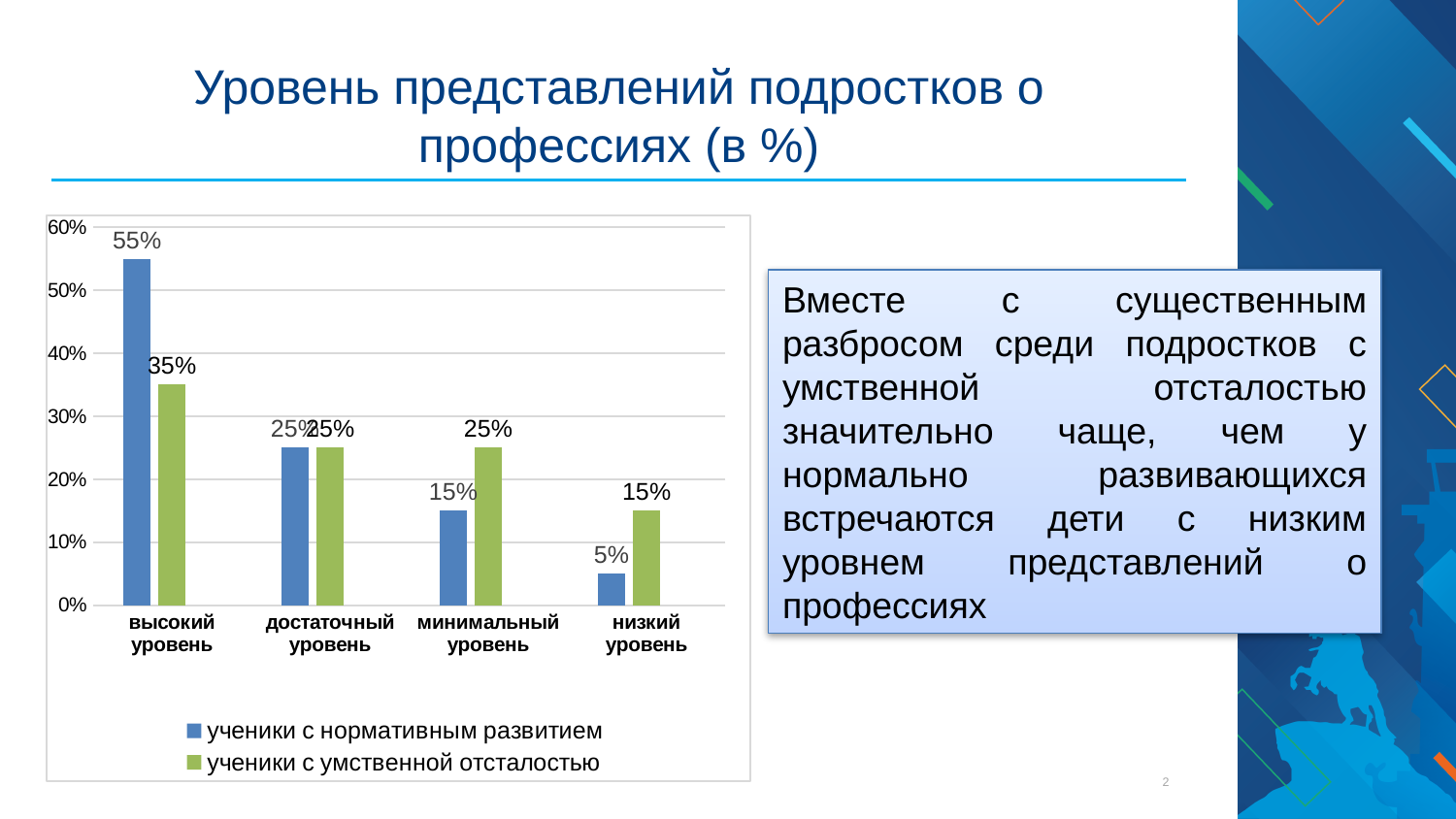
At «низкий уровень», which series has the larger value? ученики с умственной отсталостью What type of chart is shown on the slide? bar chart Which category has the highest value for «ученики с нормативным развитием»? высокий уровень How many series does the legend list? 2 What is the value for «ученики с нормативным развитием» at «высокий уровень»? 55% Which category has the lowest value for «ученики с умственной отсталостью»? низкий уровень How many categories are shown on the x axis? 4 What is the value for «ученики с умственной отсталостью» at «минимальный уровень»? 25% What is the difference between the two series at «высокий уровень»? 20% Does the value for «ученики с нормативным развитием» fall or rise from «высокий уровень» to «низкий уровень»? fall What is the value for «ученики с нормативным развитием» at «низкий уровень»? 5% What is the value for «ученики с умственной отсталостью» at «высокий уровень»? 35%